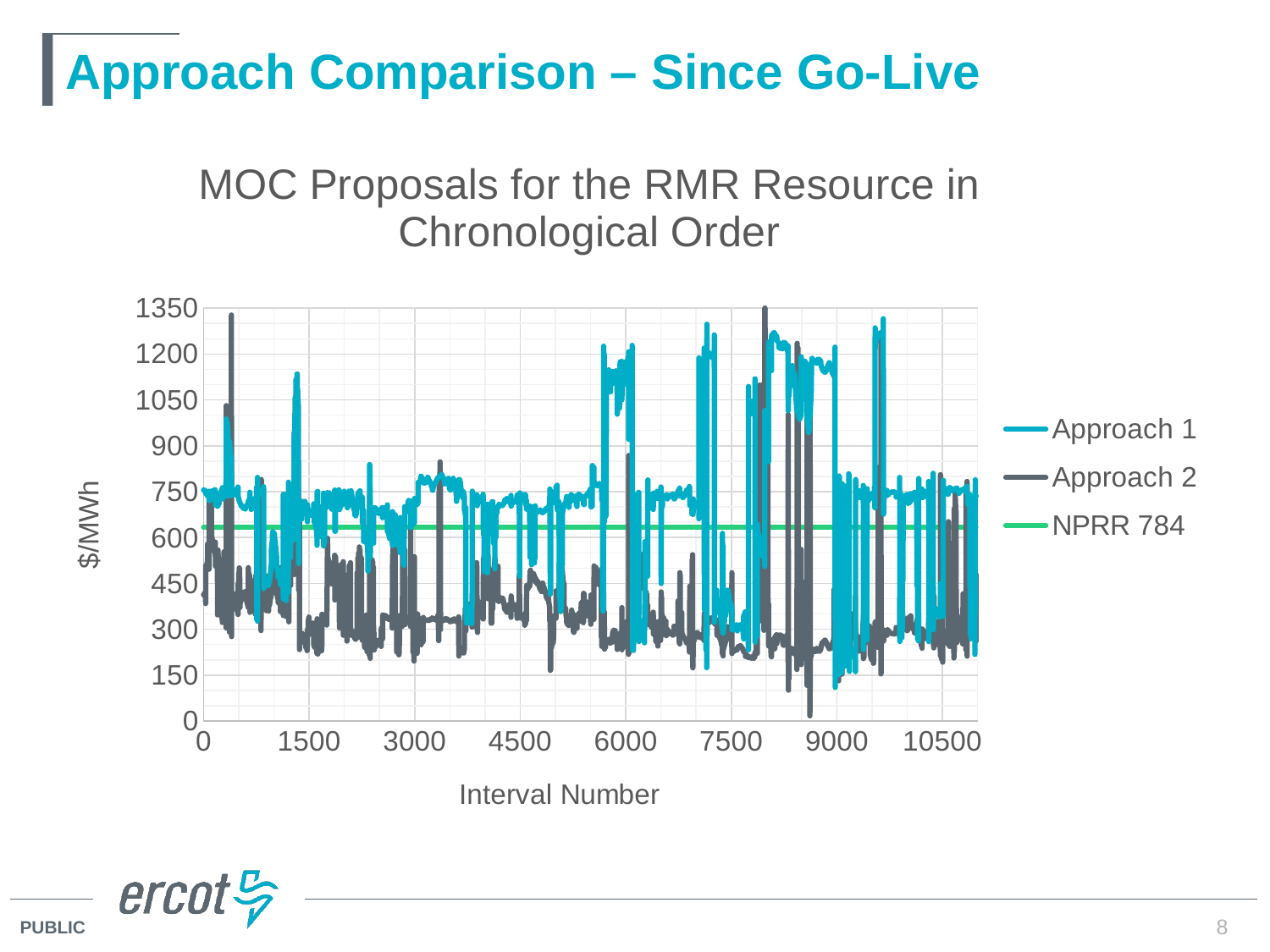
Which series is generally higher across the intervals, Approach 1 or Approach 2? Approach 1 Is the NPRR 784 line greater or less than 750 $/MWh? less Is the value of Approach 2 at interval 3000 greater or less than 600? less How many series does the legend list? 3 What kind of chart is shown on the slide? Line chart What is the label of the y axis? $/MWh What is the highest value shown on the y axis? 1350 Is the highest peak of Approach 2 greater or less than 1200? greater What is the title of the chart? MOC Proposals for the RMR Resource in Chronological Order